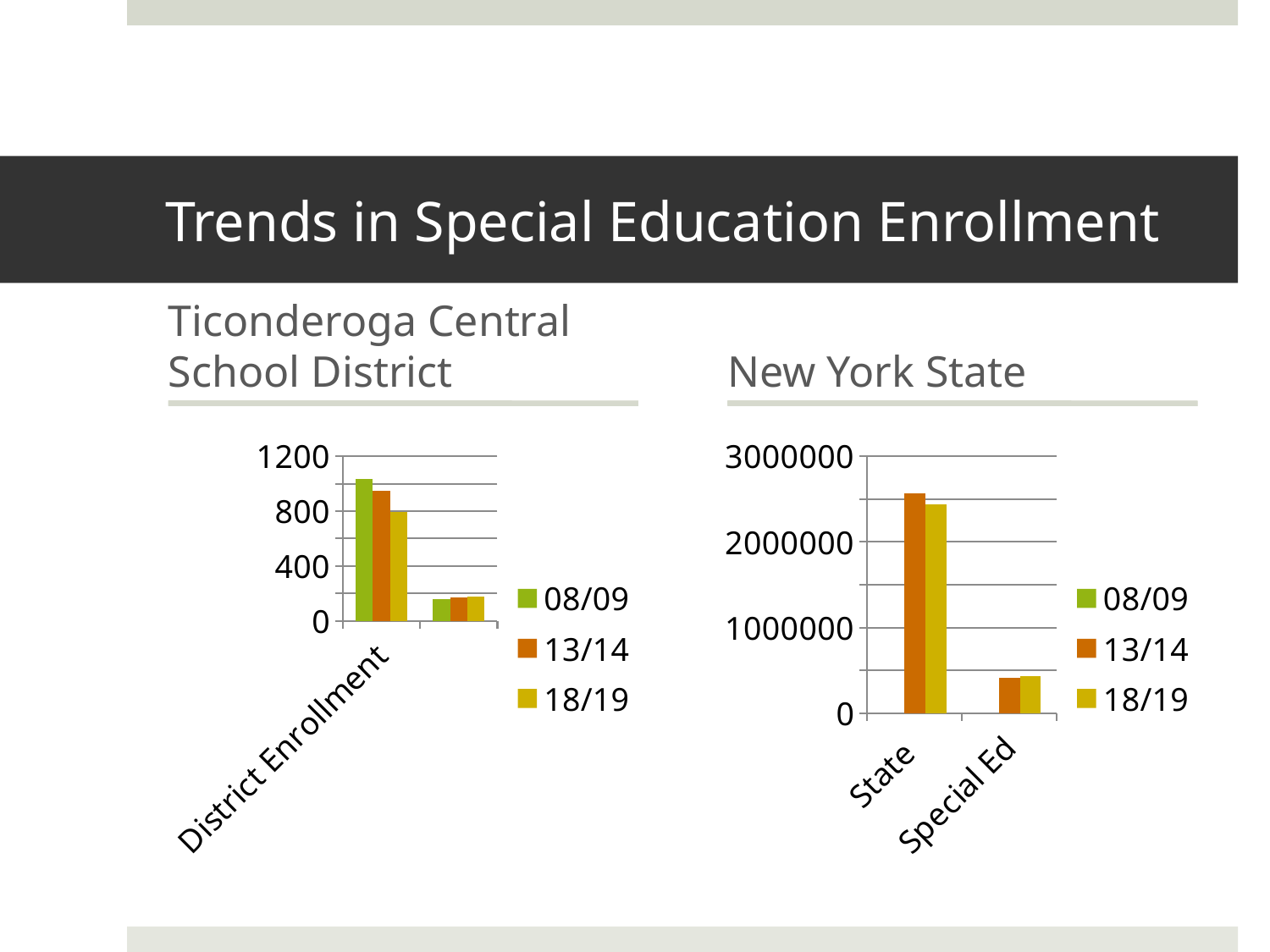
What is the title of the chart on the right side of the slide? New York State In the New York State chart, is the 13/14 value for State greater or less than 2000000? greater In the Ticonderoga Central School District chart, is the 13/14 value for District Enrollment greater or less than 1200? less How many categories are shown on the x axis of the New York State chart? 2 How many series does the legend of the New York State chart list? 3 What kind of chart is the Ticonderoga Central School District chart? bar chart In the New York State chart, which series has the higher value for State: 13/14 or 18/19? 13/14 In the Ticonderoga Central School District chart, which series has the highest District Enrollment value? 08/09 In the Ticonderoga Central School District chart, do the District Enrollment values rise or fall from 08/09 to 18/19? fall In the New York State chart, which is larger for 13/14: State or Special Ed? State In the Ticonderoga Central School District chart, is the 08/09 value for District Enrollment greater or less than 800? greater